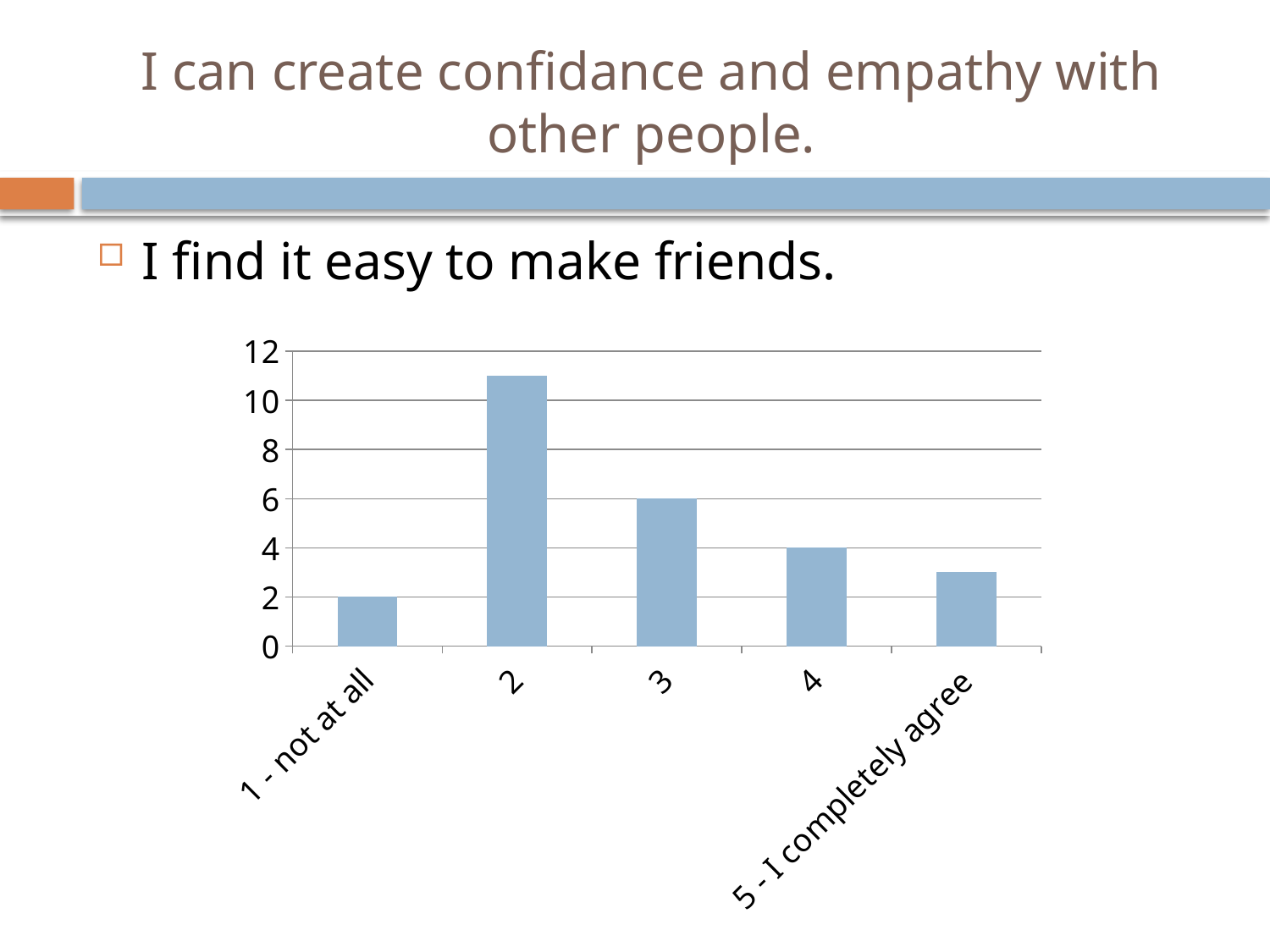
What kind of chart is shown on the slide? bar chart What is the value for the category "4"? 4 What is the value for the category "1 - not at all"? 2 Which is larger, the value for category "3" or the value for category "4"? 3 What is the difference between the values for category "3" and category "1 - not at all"? 4 What is the value for the category "3"? 6 How many categories are shown on the x axis? 5 What is the difference between the values for categories "3" and "4"? 2 Is the value for "5 - I completely agree" greater or less than 4? less Is the value for category "2" greater or less than 10? greater Which category has the highest bar? 2 Which category has the lowest bar? 1 - not at all